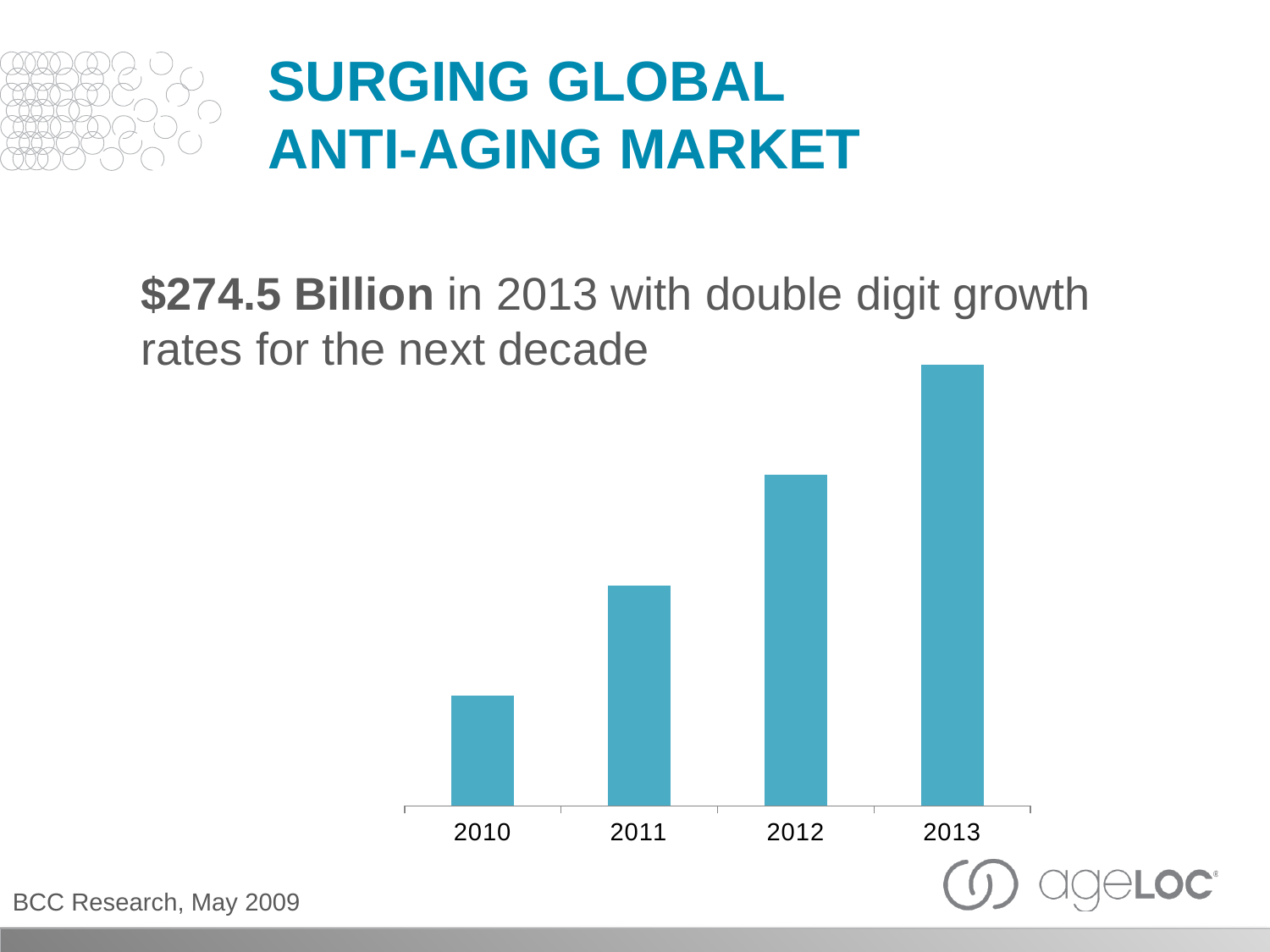
Which bar is taller, 2010 or 2013? 2013 Which year has the shortest bar in the chart? 2010 What kind of chart is shown on the slide? bar chart How many bars (years) are plotted in the chart? 4 Do the bar values rise or fall from 2010 to 2013? rise What is the first year shown on the x axis of the chart? 2010 Which year has the tallest bar in the chart? 2013 Which bar is taller, 2011 or 2012? 2012 What colour are the bars in the chart? teal blue